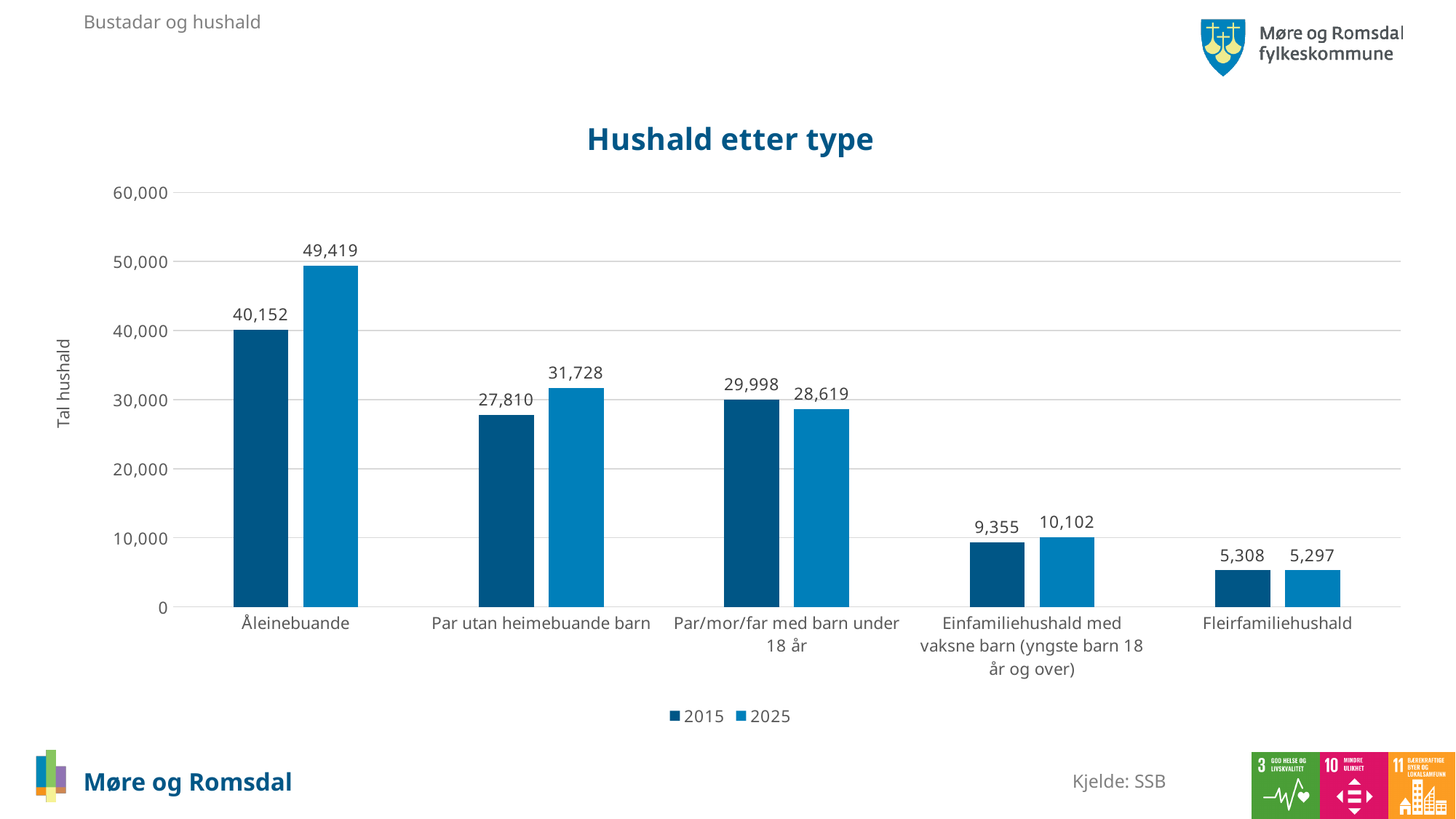
Is the 2015 value for Par utan heimebuande barn greater or less than 30,000? less What type of chart is shown on the slide? bar chart What is the 2025 value for Einfamiliehushald med vaksne barn (yngste barn 18 år og over)? 10,102 For Par/mor/far med barn under 18 år, which is larger: the 2015 value or the 2025 value? 2015 What is the 2025 value for Åleinebuande? 49,419 Which category has the lowest 2025 value? Fleirfamiliehushald What is the title of the chart? Hushald etter type What is the 2015 value for Par utan heimebuande barn? 27,810 Which category has the highest 2015 value? Åleinebuande What is the difference between the 2025 and 2015 values for Åleinebuande? 9,267 How many series does the legend list? 2 How many household type categories are shown on the x axis? 5